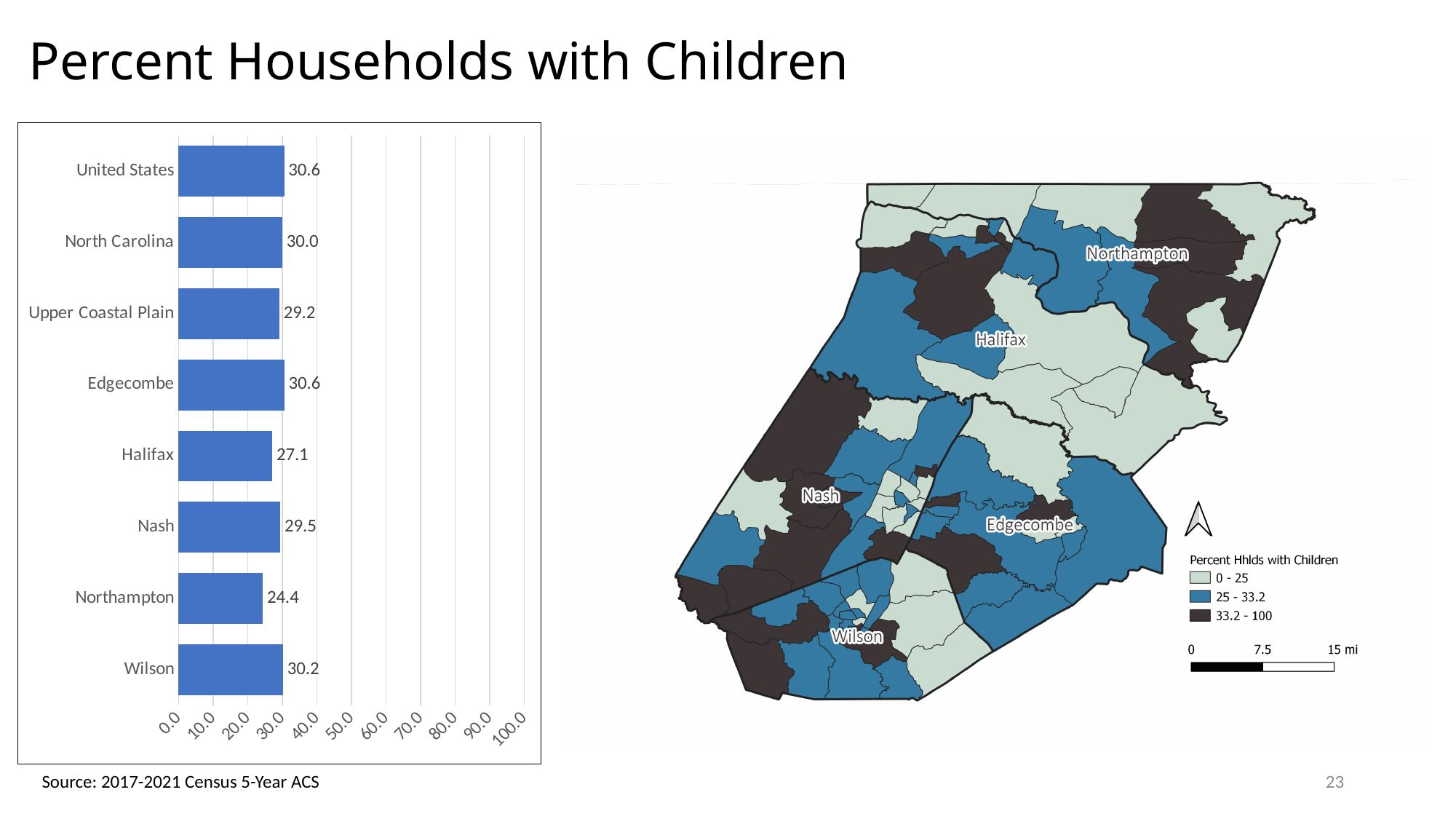
What is the value for Upper Coastal Plain in the bar chart? 29.2 What is the difference between the values for United States and Halifax in the bar chart? 3.5 What is the value for Wilson in the bar chart? 30.2 How many categories are shown in the bar chart? 8 What is the value for Northampton in the bar chart? 24.4 What kind of chart is shown on the left of the slide? bar chart What is the title of the slide containing the bar chart? Percent Households with Children What is the difference between the values for Nash and Northampton in the bar chart? 5.1 In the bar chart, which is larger, the value for Wilson or the value for Halifax? Wilson Which category has the lowest value in the bar chart? Northampton In the bar chart, is the value for Northampton greater or less than 30.0? less What is the value for Halifax in the bar chart? 27.1